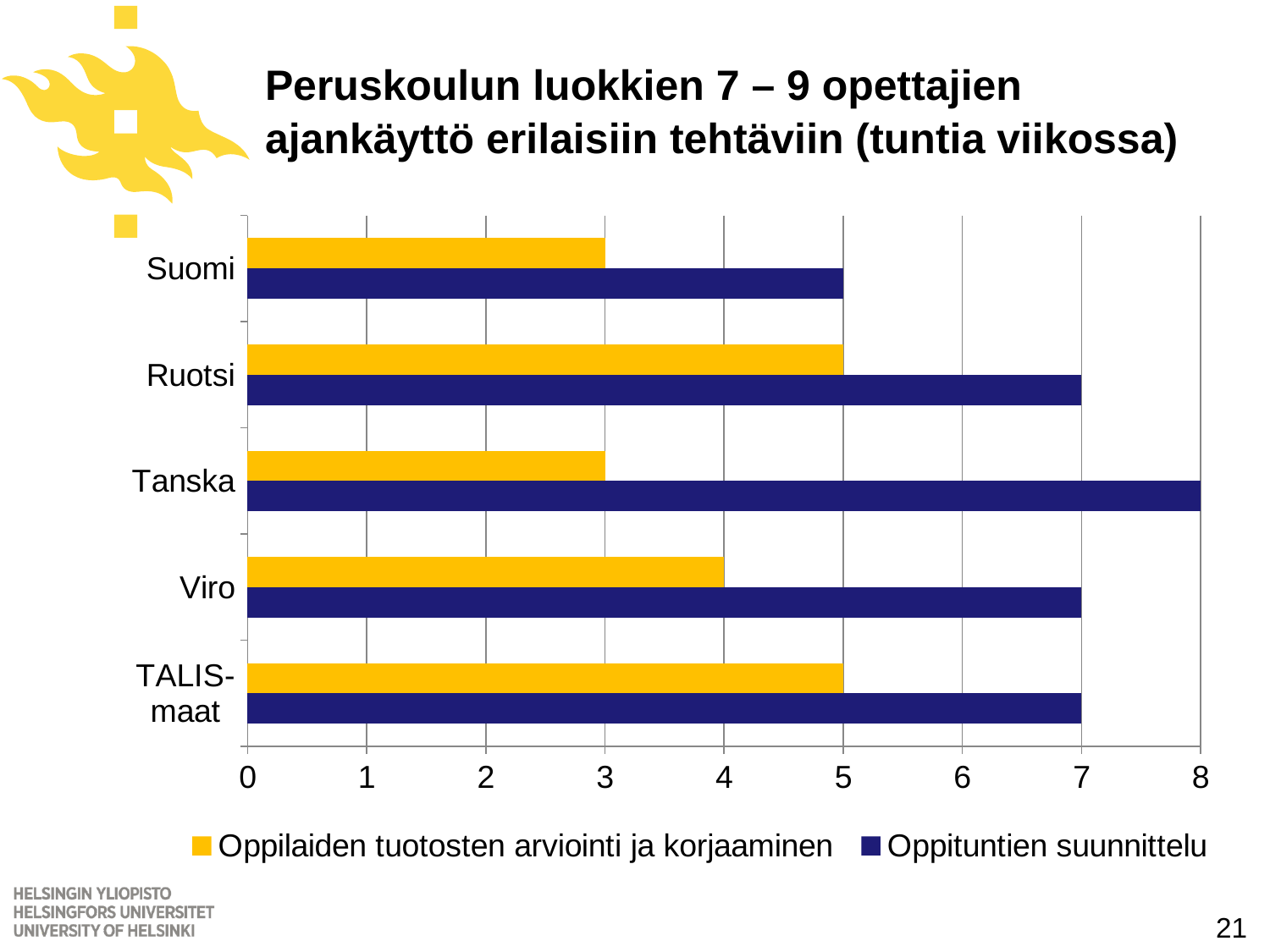
Which category has the lowest value for Oppituntien suunnittelu? Suomi Is the value of Oppituntien suunnittelu for Viro greater or less than 6? greater What kind of chart is shown on the slide? bar chart What is the value of Oppituntien suunnittelu for Tanska? 8 Which is larger for Ruotsi: Oppilaiden tuotosten arviointi ja korjaaminen or Oppituntien suunnittelu? Oppituntien suunnittelu Which category has the highest value for Oppituntien suunnittelu? Tanska How many categories are shown on the vertical axis? 5 What is the value of Oppilaiden tuotosten arviointi ja korjaaminen for Viro? 4 What is the value of Oppituntien suunnittelu for Suomi? 5 How many series does the legend list? 2 What is the difference between Oppituntien suunnittelu and Oppilaiden tuotosten arviointi ja korjaaminen for Tanska? 5 Which colour represents Oppilaiden tuotosten arviointi ja korjaaminen in the legend? yellow